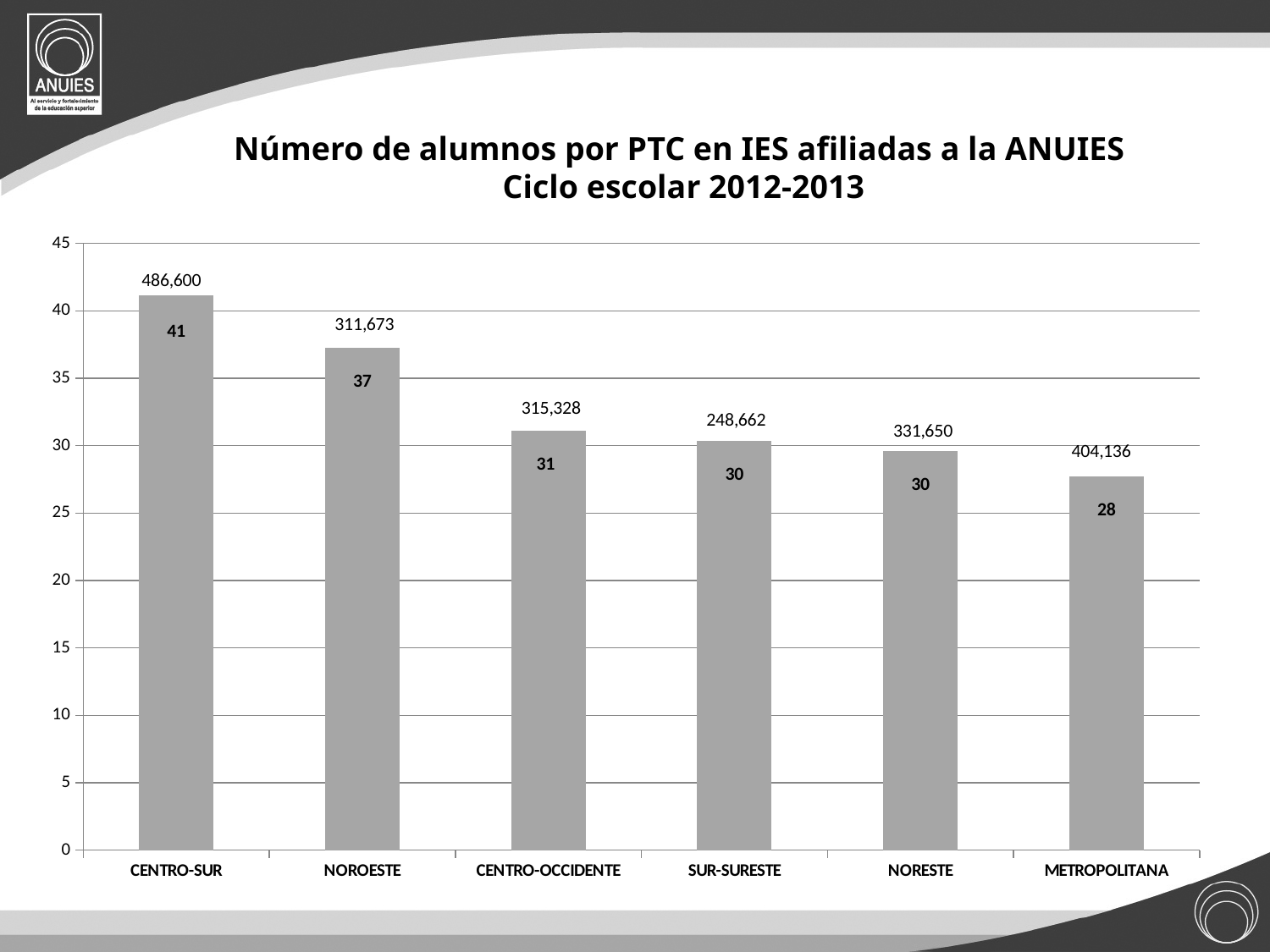
What is the difference between the bold values inside the bars for CENTRO-SUR and METROPOLITANA? 13 How many regions are shown on the x axis of the chart? 6 Do the bar heights rise or fall moving from left to right along the x axis? fall Which region has the tallest bar? CENTRO-SUR Which has a taller bar, NOROESTE or CENTRO-OCCIDENTE? NOROESTE What is the number printed above the bar for SUR-SURESTE? 248,662 What is the bold value inside the bar for NOROESTE? 37 Which region has the shortest bar? METROPOLITANA What is the number of students per PTC (the bold value inside the bar) for CENTRO-SUR? 41 What type of chart is shown on the slide? bar chart What is the number printed above the bar for CENTRO-SUR? 486,600 What is the bold value inside the bar for METROPOLITANA? 28